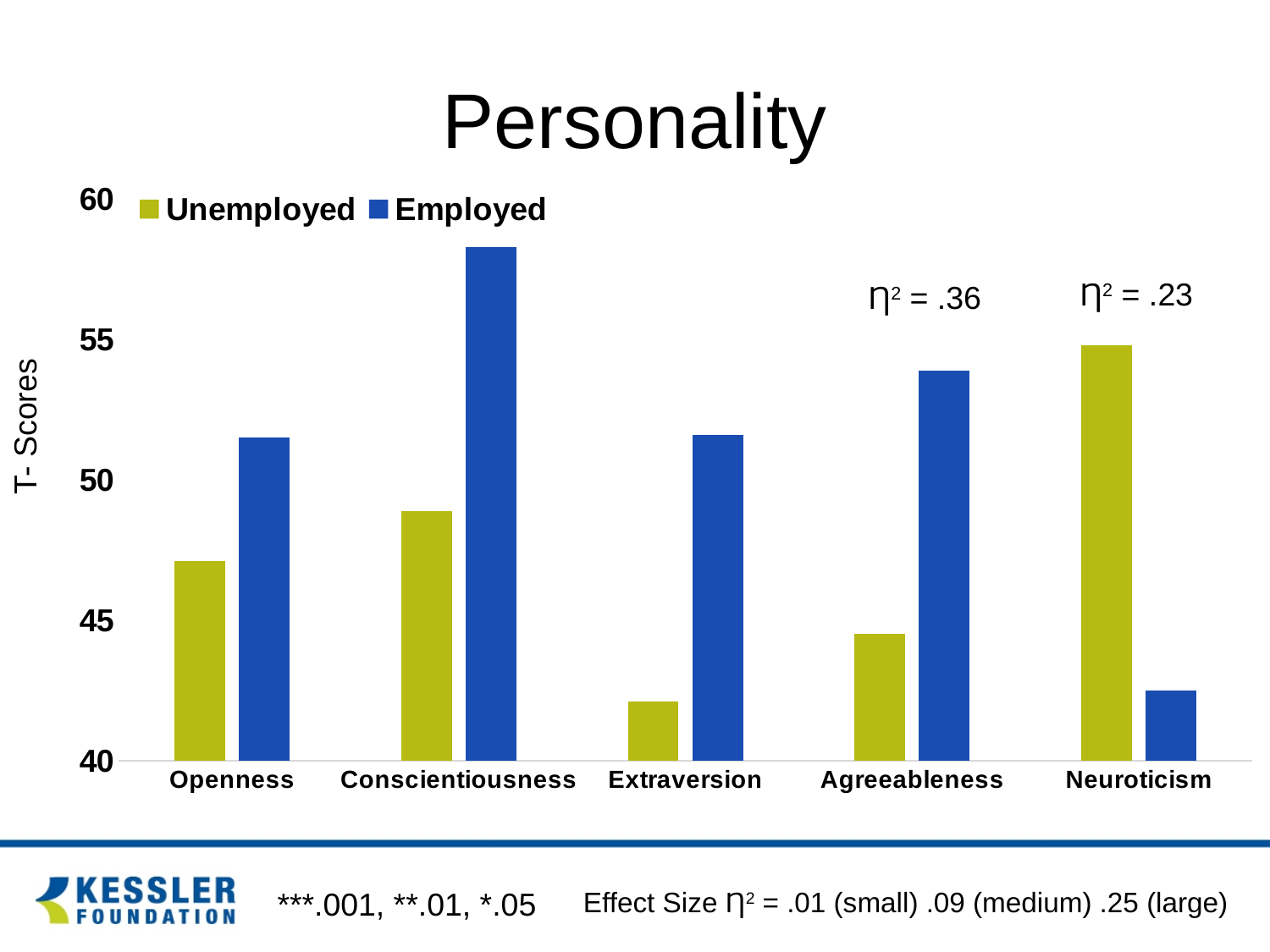
Is the Employed value for Conscientiousness greater or less than 55? greater For Neuroticism, which is larger, the Unemployed value or the Employed value? Unemployed Which category has the lowest Employed value? Neuroticism Which category has the lowest Unemployed value? Extraversion For Extraversion, which is larger, the Unemployed value or the Employed value? Employed Is the Unemployed value for Extraversion greater or less than 45? less Which category has the highest Unemployed value? Neuroticism What is the label on the y axis of the chart? T- Scores Which category has the highest Employed value? Conscientiousness How many personality categories are shown on the x axis? 5 How many series does the legend list? 2 What kind of chart is shown on the slide? bar chart